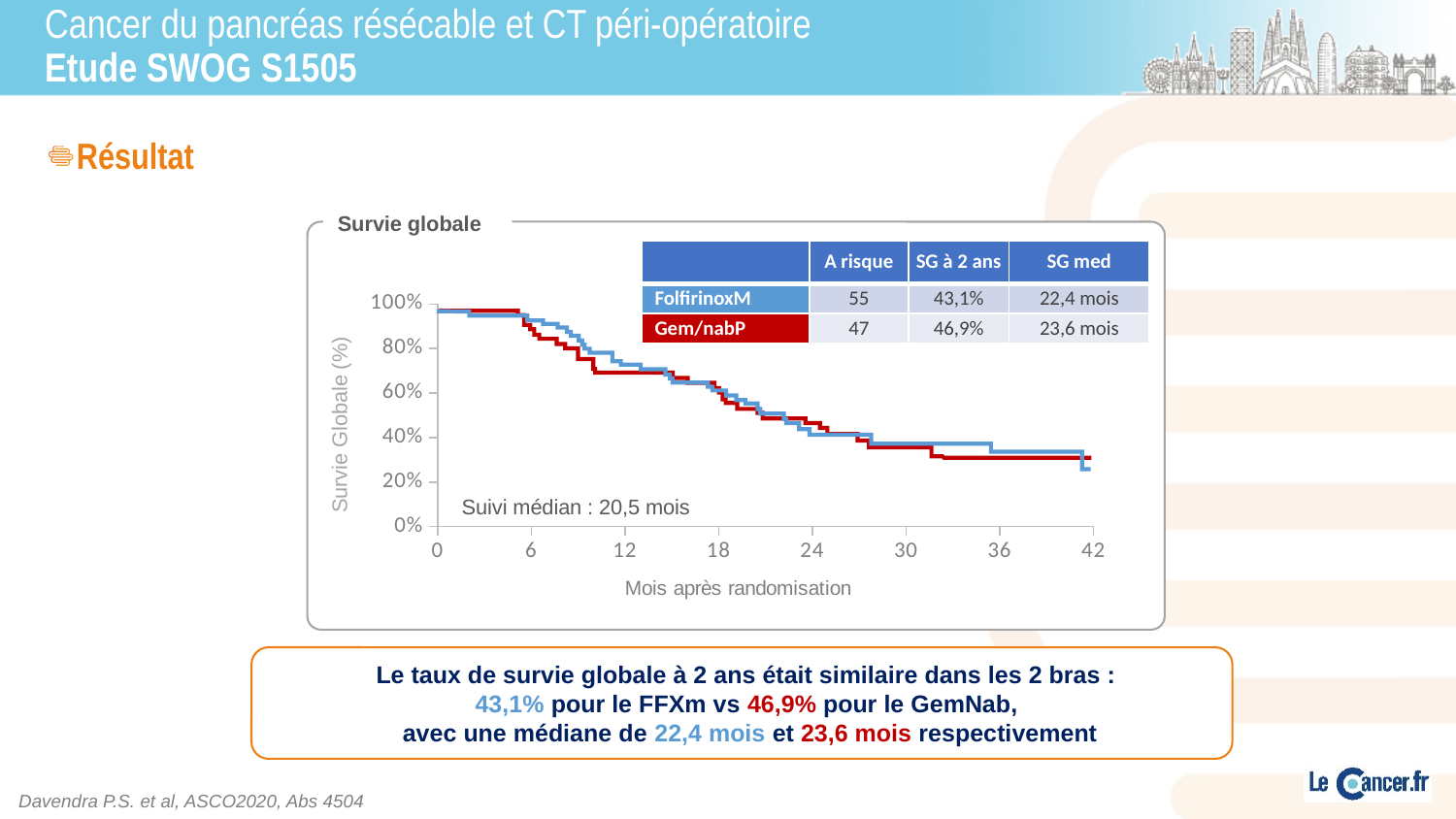
What is the median overall survival (SG med) for the Gem/nabP arm? 23,6 mois What is the median follow-up (Suivi médian) stated on the chart? 20,5 mois Do the survival curves rise or fall as months after randomisation increase? Fall What is the difference in median overall survival between the Gem/nabP and FolfirinoxM arms? 1,2 mois Which arm has the higher 2-year overall survival rate? Gem/nabP Which colour represents the Gem/nabP arm on the survival chart? Red What is the 2-year overall survival rate (SG à 2 ans) for the Gem/nabP arm? 46,9% How many patients are at risk (A risque) in the Gem/nabP arm? 47 What kind of chart is shown under the title "Survie globale"? Line chart (Kaplan-Meier survival curve) What is the median overall survival (SG med) for the FolfirinoxM arm? 22,4 mois What is the 2-year overall survival rate (SG à 2 ans) for the FolfirinoxM arm? 43,1% How many treatment arms (series) are plotted on the survival chart? 2